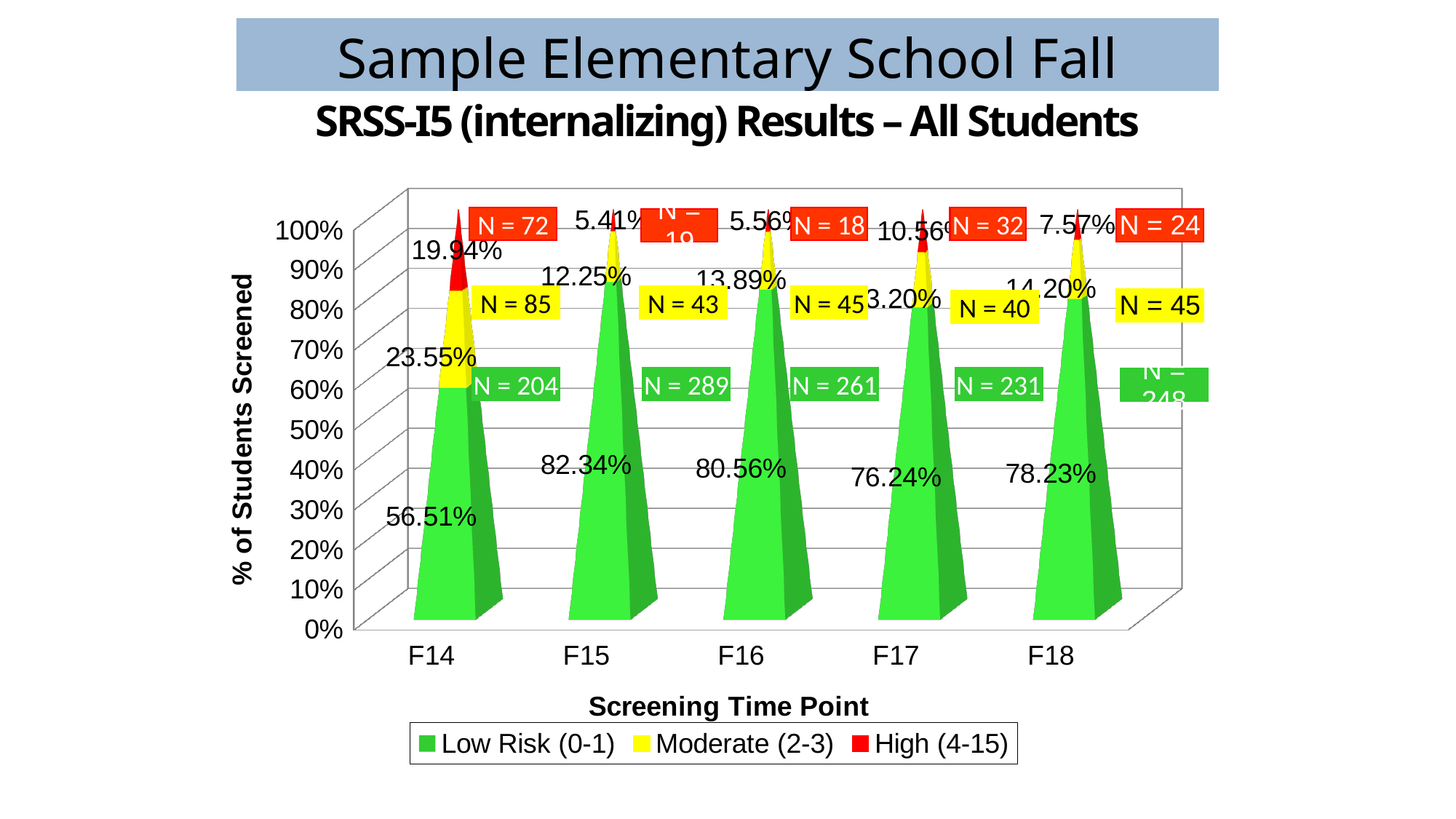
How many series does the legend list? 3 What is the N value shown for the Low Risk group at F15? N = 289 What is the Moderate (2-3) percentage for F16? 13.89% Which has a larger Low Risk (0-1) percentage, F16 or F18? F16 Which screening time point has the lowest Low Risk (0-1) percentage? F14 What kind of chart is shown on the slide? Stacked bar chart How many screening time points are shown on the x axis? 5 What is the title of the x axis? Screening Time Point What is the difference between the Low Risk (0-1) percentages for F15 and F14? 25.83% What is the High (4-15) percentage for F18? 7.57% What is the Low Risk (0-1) percentage for F14? 56.51% Which screening time point has the highest Low Risk (0-1) percentage? F15